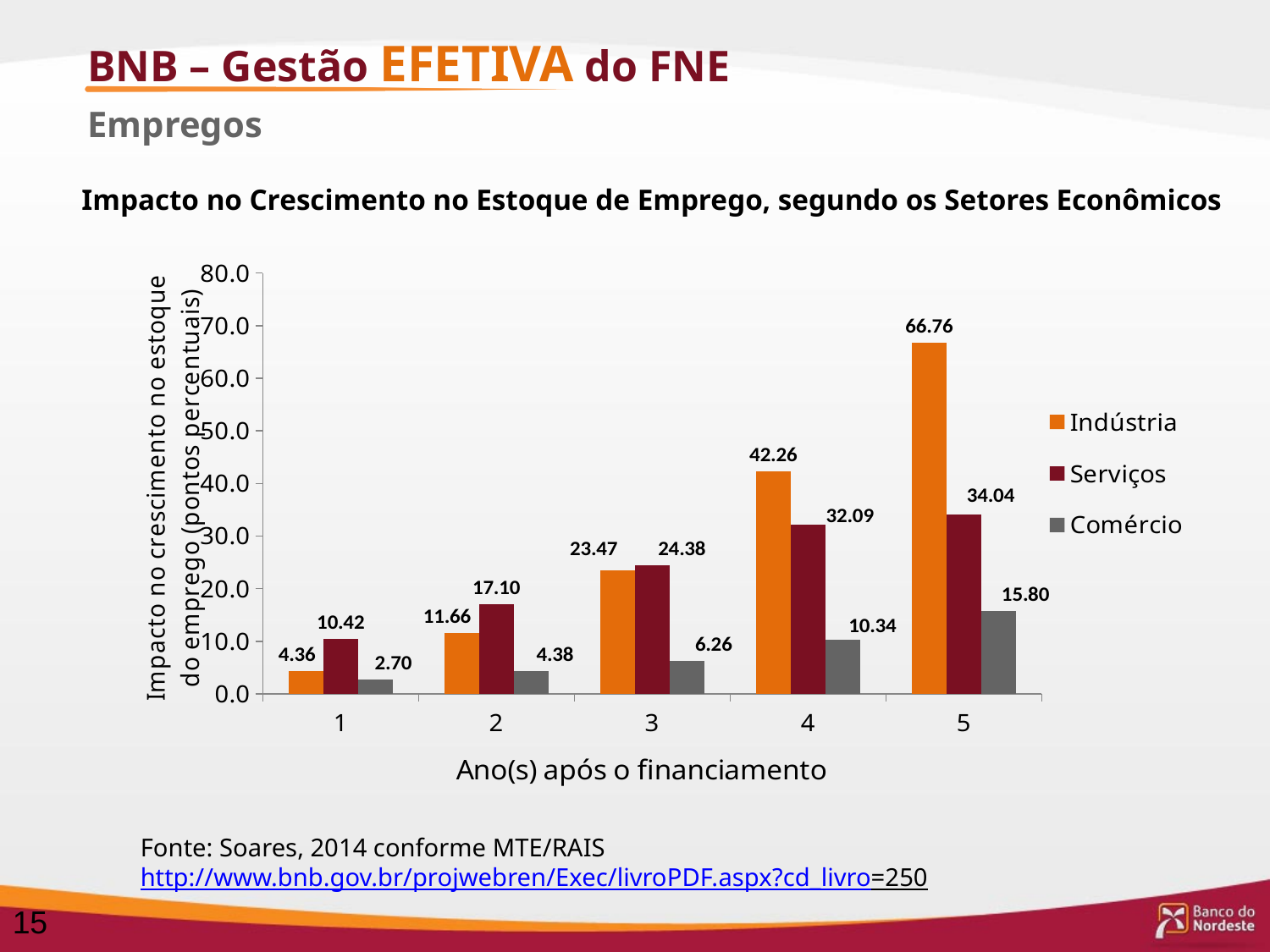
What is the difference between the Indústria and Serviços values in year 5? 32.72 How many series does the legend list? 3 In year 3, which is larger: Indústria or Serviços? Serviços How many years after financing are shown on the x axis? 5 Is the value for Indústria in year 4 greater or less than 40.0? greater What is the value for Indústria in year 5 after financing? 66.76 What is the value for Comércio in year 4 after financing? 10.34 Which year after financing has the highest value for Indústria? 5 What is the value for Serviços in year 2 after financing? 17.10 Which year after financing has the lowest value for Comércio? 1 Do the Serviços values rise or fall from year 1 to year 5? Rise What kind of chart is shown on the slide? Bar chart